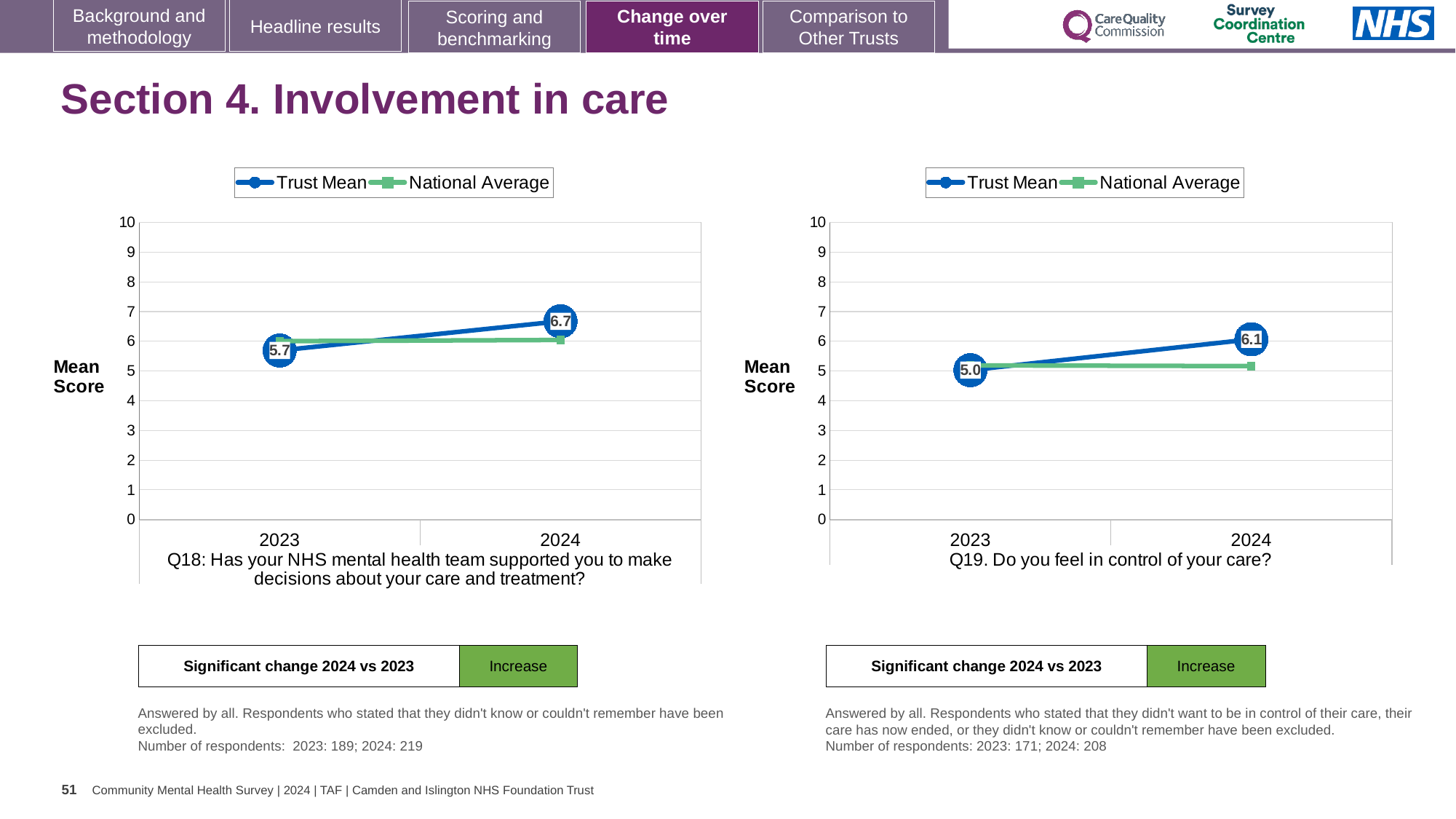
In the right chart (Q19), does the Trust Mean rise or fall from 2023 to 2024? rise What kind of chart is the right chart (Q19)? line chart In the left chart (Q18), which is larger in 2024, the Trust Mean or the National Average? Trust Mean In the left chart (Q18), by how much did the Trust Mean change from 2023 to 2024? 1.0 How many series does the legend of the left chart (Q18) list? 2 In the left chart (Q18), what is the Trust Mean score for 2023? 5.7 In the right chart (Q19), by how much did the Trust Mean change from 2023 to 2024? 1.1 In the right chart (Q19), what is the Trust Mean score for 2023? 5.0 In the right chart (Q19), is the National Average value for 2024 greater or less than 6? less In the left chart (Q18), what is the Trust Mean score for 2024? 6.7 How many years are shown on the x axis of the left chart (Q18)? 2 In the right chart (Q19), what is the Trust Mean score for 2024? 6.1